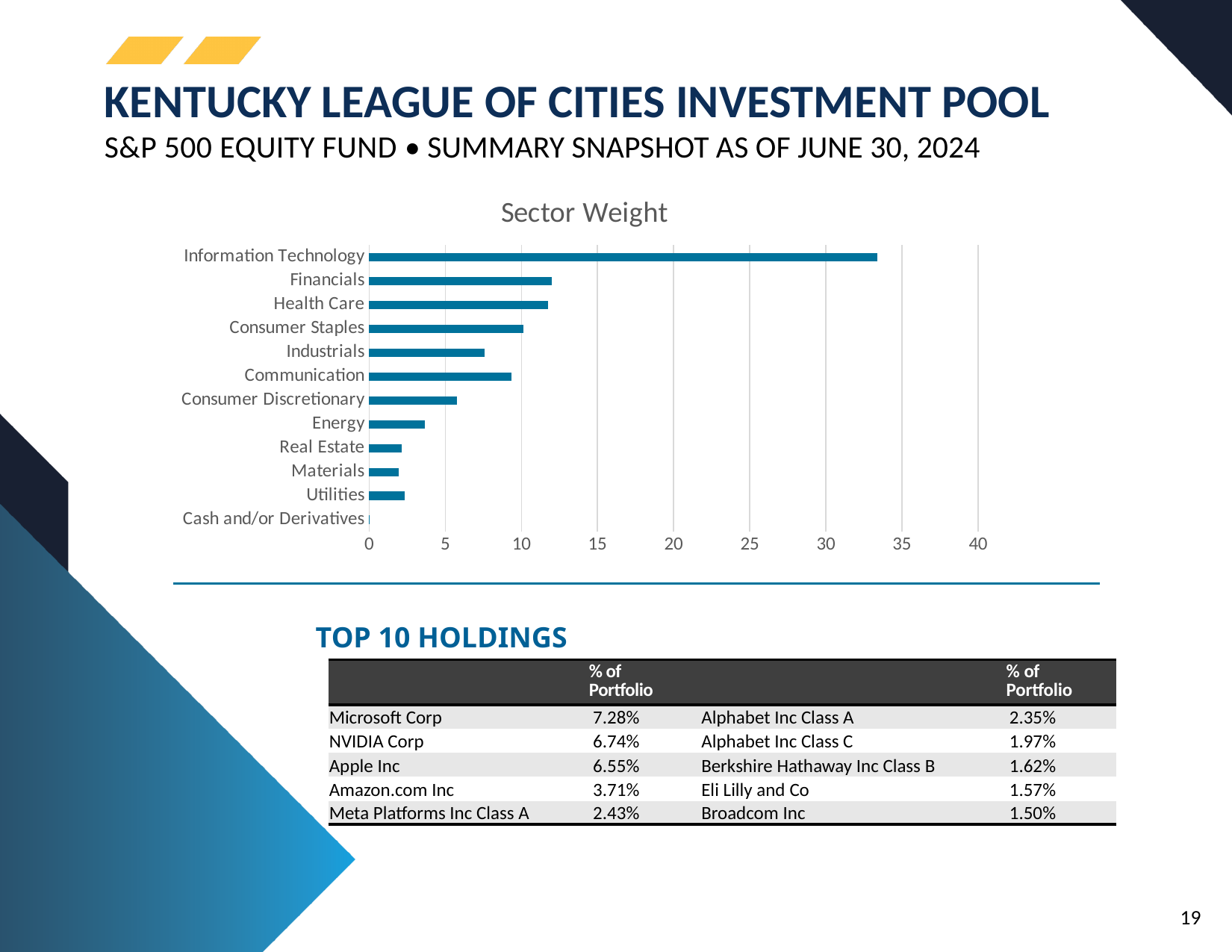
Is the value for Energy greater or less than 5? less Which has a larger sector weight, Information Technology or Financials? Information Technology Which sector has the highest weight on the Sector Weight chart? Information Technology Is the value for Information Technology greater or less than 30? greater How many sectors are listed on the Sector Weight chart? 12 Which has a larger sector weight, Consumer Staples or Consumer Discretionary? Consumer Staples Is the value for Financials greater or less than 10? greater Which has a larger sector weight, Communication or Industrials? Communication Which category has the lowest value on the Sector Weight chart? Cash and/or Derivatives What is the title of the chart on the slide? Sector Weight What kind of chart is the Sector Weight chart? bar chart